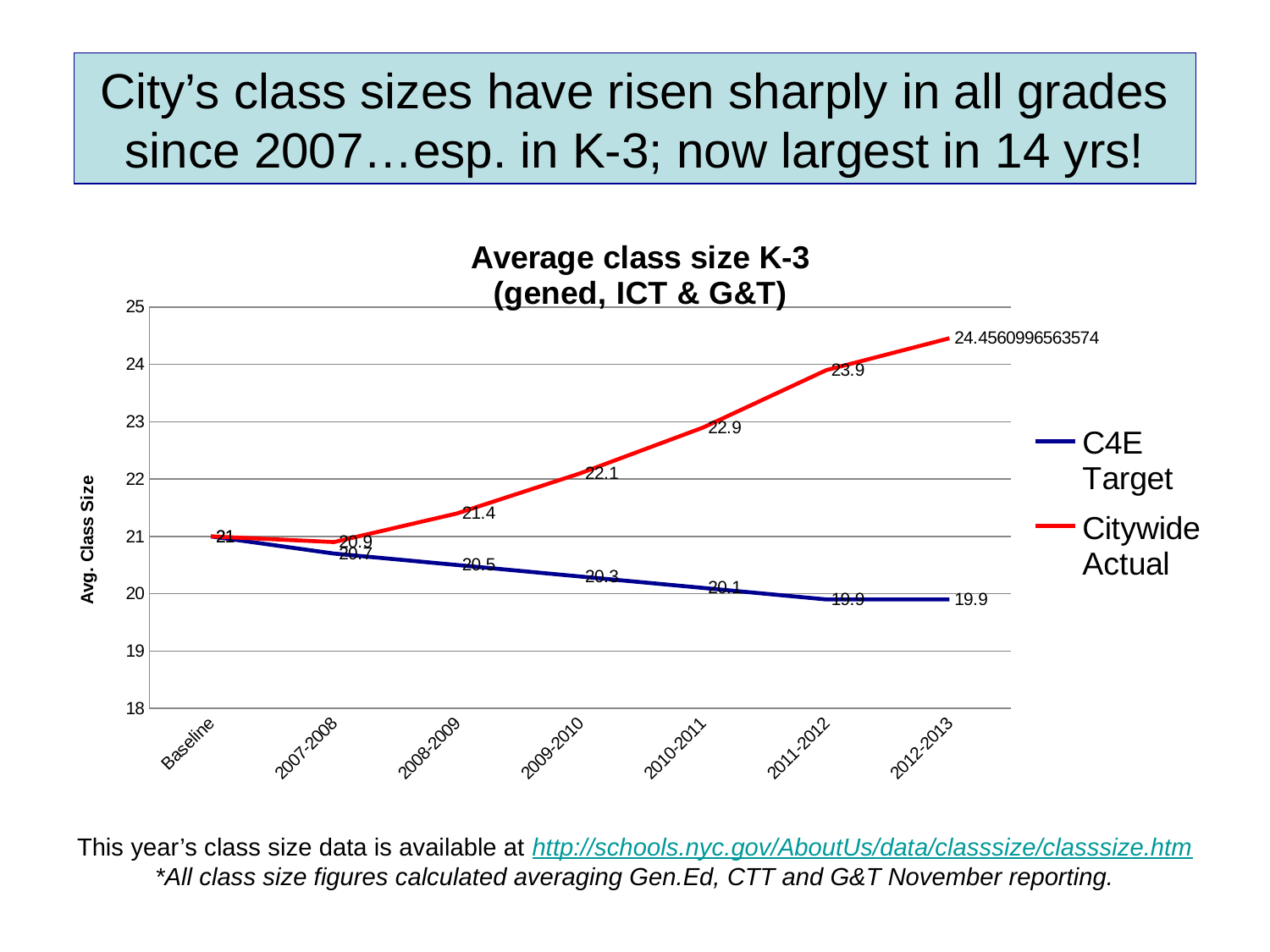
What is the Citywide Actual value for 2008-2009? 21.4 In which year is the Citywide Actual value highest? 2012-2013 What is the C4E Target value for 2012-2013? 19.9 How many points are plotted along the x axis for each series? 7 What is the difference between the Citywide Actual and C4E Target values in 2011-2012? 4 What kind of chart is shown on the slide? Line chart What is the Citywide Actual value for 2011-2012? 23.9 How many series does the legend list? 2 Does the C4E Target series rise or fall from Baseline to 2012-2013? Fall What is the title of the y axis? Avg. Class Size What is the Citywide Actual value for 2012-2013? 24.4560996563574 In 2010-2011, which series has the larger value, C4E Target or Citywide Actual? Citywide Actual